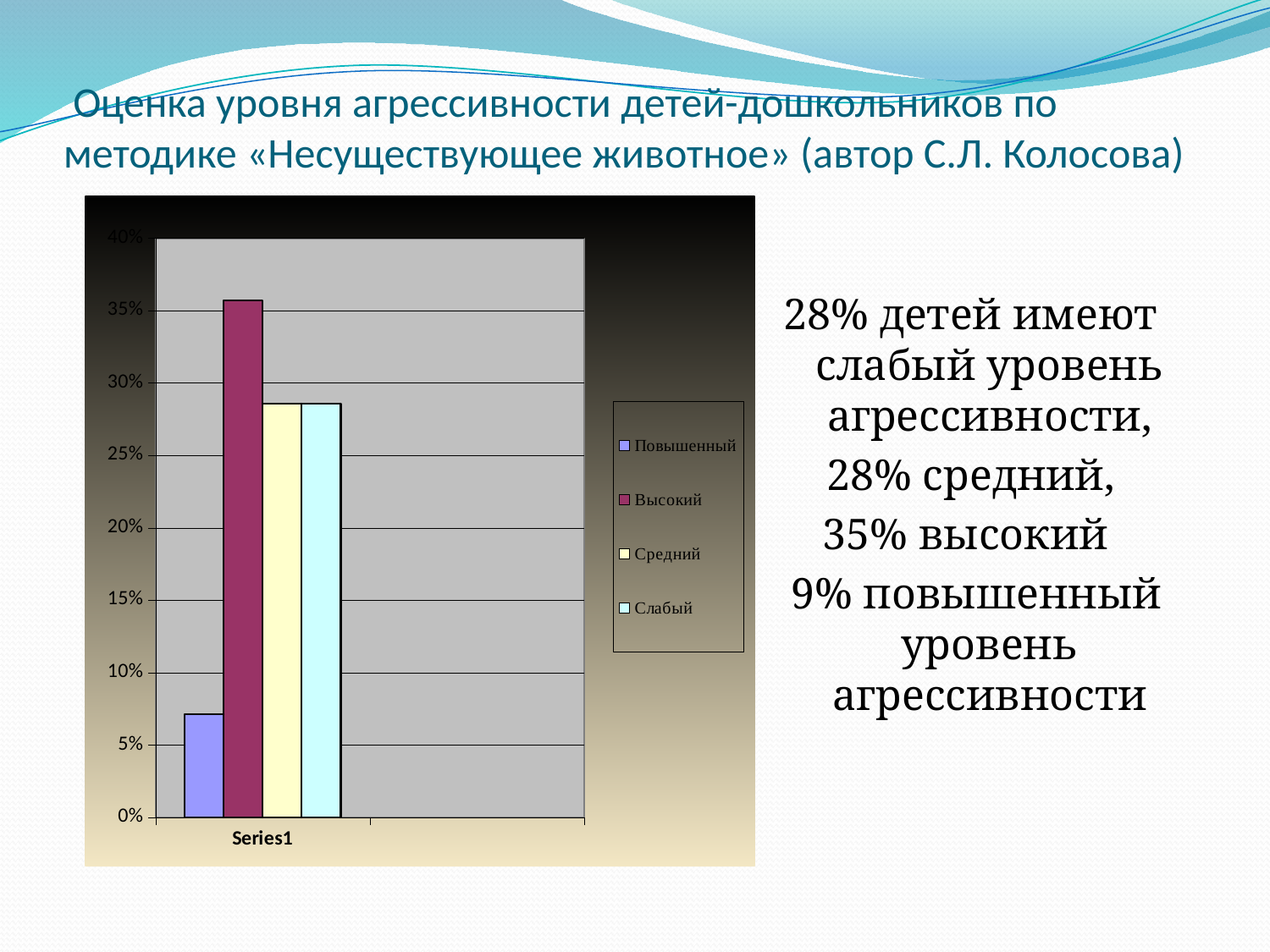
What is the highest value shown on the chart's vertical axis? 40% What is the label shown on the category axis of the chart? Series1 How many series does the chart legend list? 4 Which series has the tallest bar in the chart? Высокий Is the value for Высокий greater or less than 30%? greater Which is larger, the bar for Высокий or the bar for Повышенный? Высокий Which series has the shortest bar in the chart? Повышенный Is the value for Повышенный greater or less than 10%? less What kind of chart is shown on the slide? bar chart Is the value for Средний greater or less than 25%? greater How many bars are plotted in the chart? 4